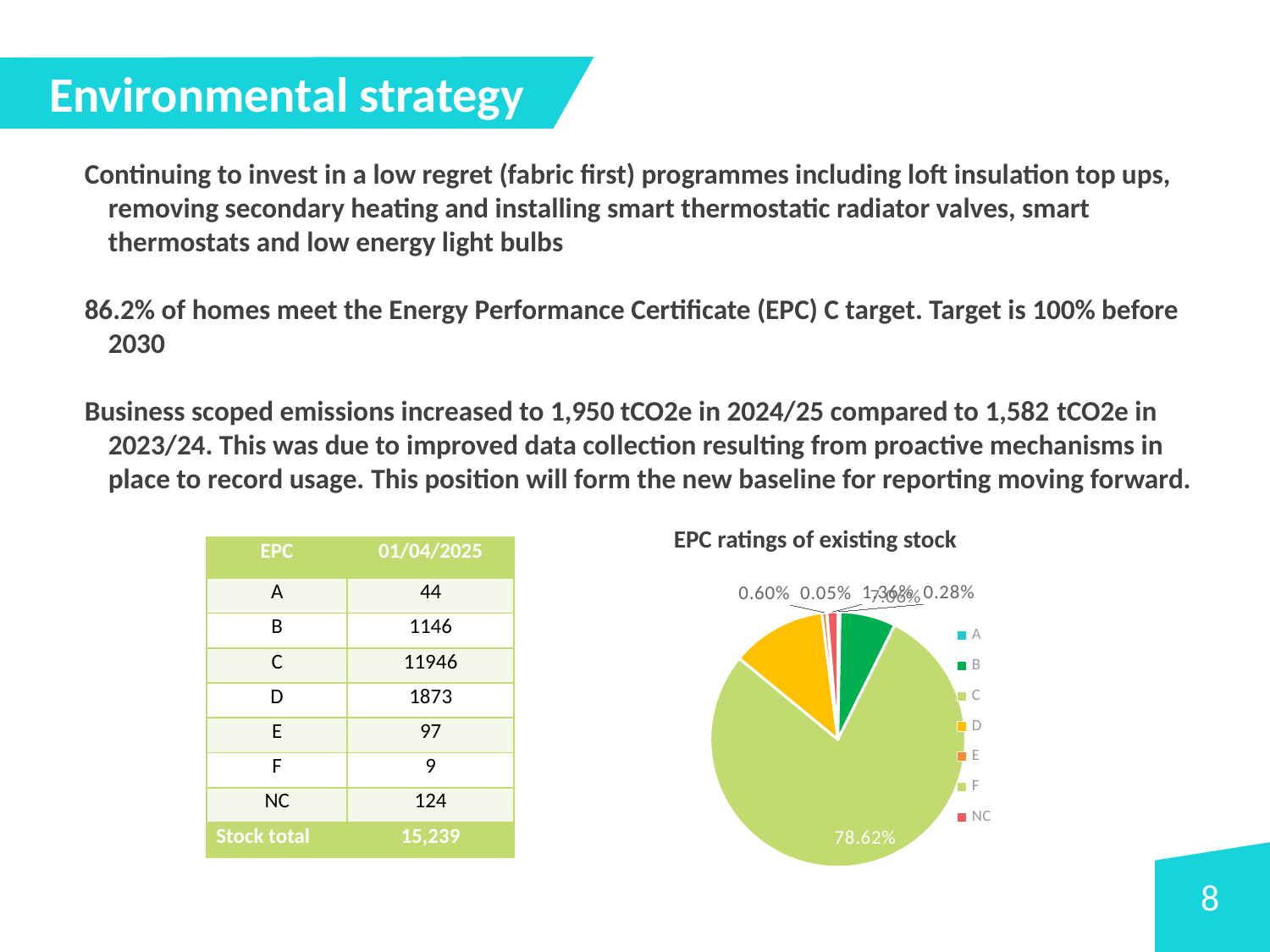
What kind of chart is shown on the slide? pie chart Which slice is larger in the pie chart, B or A? B What share of the pie does EPC rating C account for? 78.62% Which legend entry is listed last in the pie chart's legend? NC How many categories does the legend of the pie chart list? 7 Which EPC rating has the largest slice in the pie chart? C What colour is the slice for EPC rating C in the pie chart? light green Which slice is larger in the pie chart, D or B? D What is the title of the chart on the slide? EPC ratings of existing stock Which slice is larger in the pie chart, C or D? C